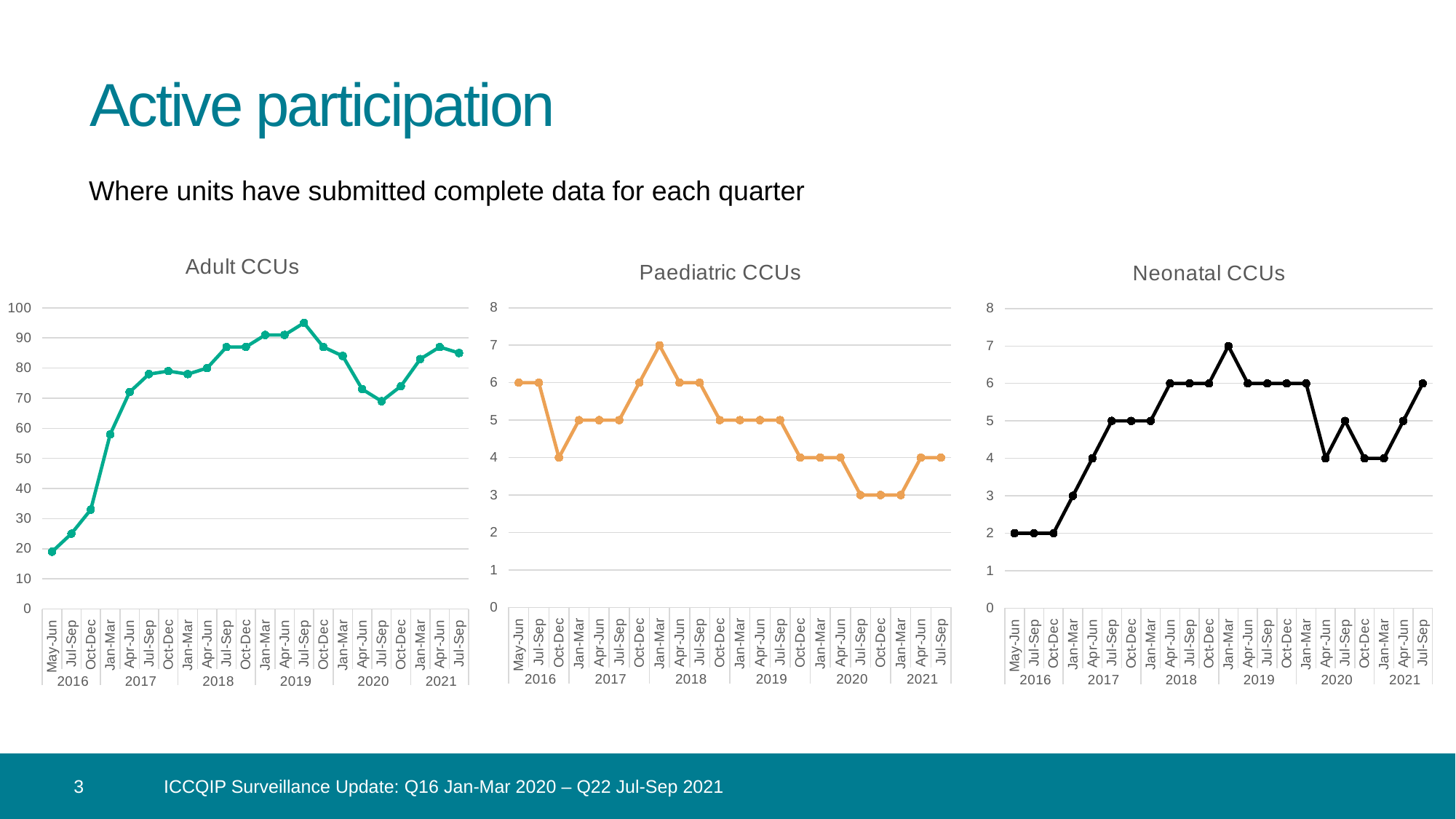
In the Paediatric CCUs chart, which quarter has the highest value? Jan-Mar 2018 In the Neonatal CCUs chart, which quarter has the highest value? Jan-Mar 2019 How many data points are plotted in the Paediatric CCUs chart? 22 What type of chart is the Adult CCUs chart? line chart In the Neonatal CCUs chart, what is the difference between the value for Jan-Mar 2019 and the value for May-Jun 2016? 5 In the Neonatal CCUs chart, what is the value for May-Jun 2016? 2 In the Adult CCUs chart, which quarter has the lowest value? May-Jun 2016 In the Neonatal CCUs chart, what is the value for Jul-Sep 2021? 6 In the Paediatric CCUs chart, what is the value for Jan-Mar 2018? 7 In the Paediatric CCUs chart, what is the value for Oct-Dec 2016? 4 In the Adult CCUs chart, is the value for Jul-Sep 2019 greater or less than 90? greater